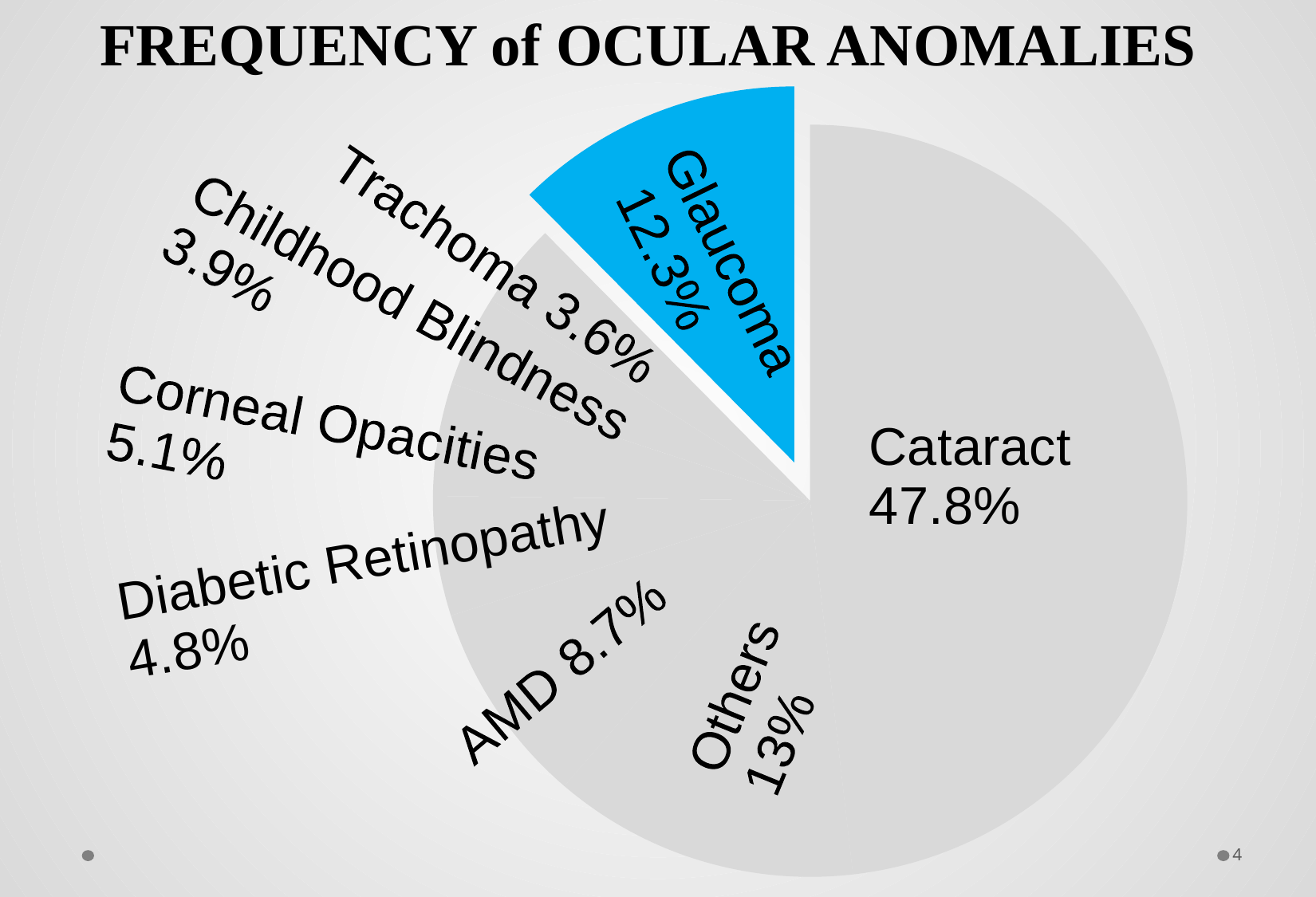
What percentage is shown for Trachoma? 3.6% Which category has the largest share of the pie? Cataract What percentage is shown for AMD? 8.7% Which category has the smallest share of the pie? Trachoma What percentage is shown for Cataract? 47.8% Which is larger, Corneal Opacities or Diabetic Retinopathy? Corneal Opacities What percentage is shown for Glaucoma? 12.3% What kind of chart is shown on the slide? Pie chart What is the title of the chart? FREQUENCY of OCULAR ANOMALIES Which slice of the pie is highlighted in blue? Glaucoma How many categories are shown in the pie chart? 8 What is the difference between the Cataract and Glaucoma percentages? 35.5%